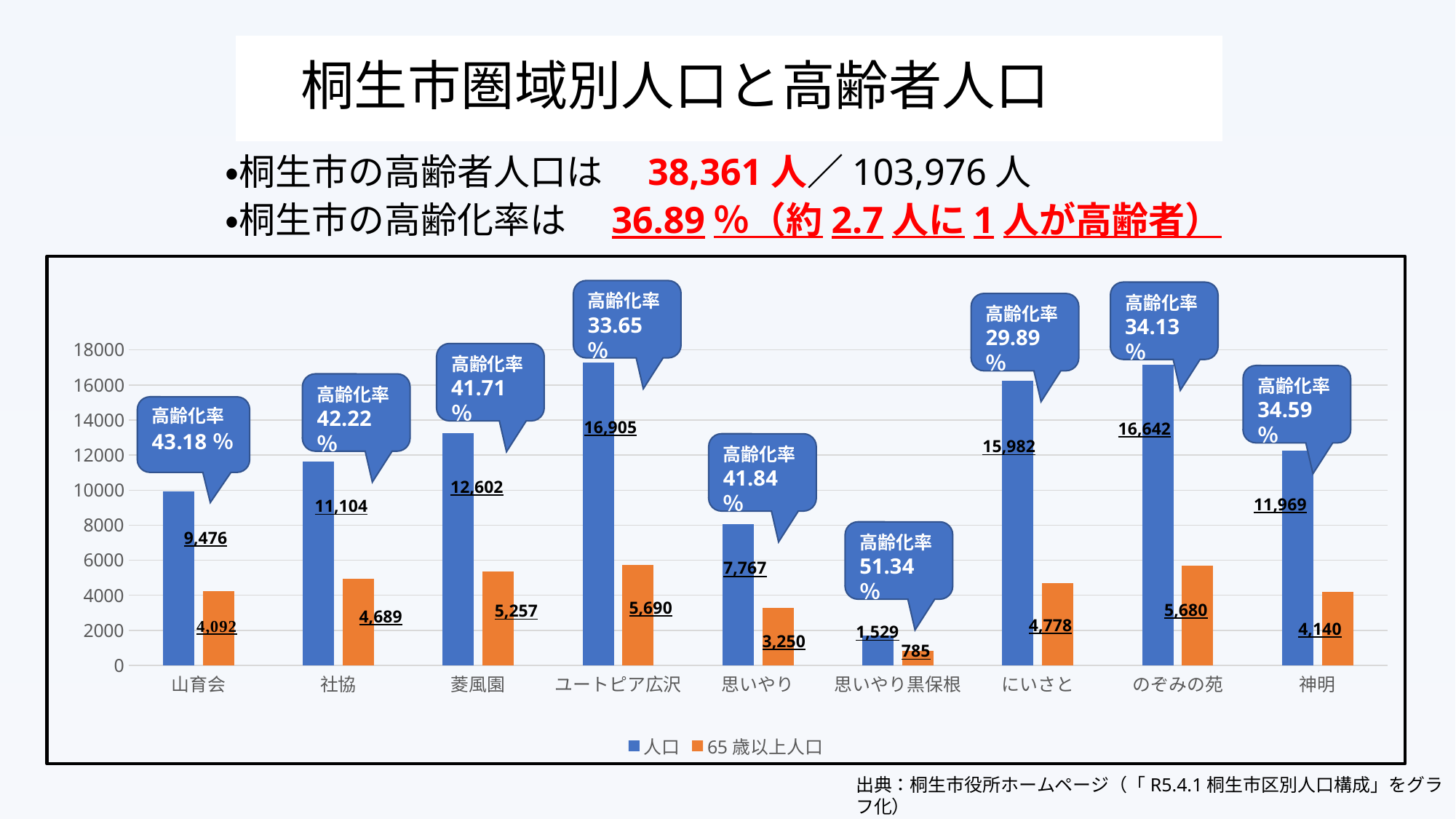
Which category has the lowest 人口 value? 思いやり黒保根 What is the 人口 value for ユートピア広沢? 16,905 What is the 65歳以上人口 value for 思いやり黒保根? 785 What 高齢化率 is shown in the callout for 思いやり黒保根? 51.34% How many categories are shown on the x axis of the chart? 9 Which has a larger 人口 value, にいさと or 神明? にいさと Which category has the highest 人口 value? ユートピア広沢 What is the difference between the 人口 values for 社協 and 山育会? 1,628 What is the difference between the 人口 and 65歳以上人口 values for ユートピア広沢? 11,215 How many series does the chart legend list? 2 What kind of chart is shown on the slide? Bar chart What is the 65歳以上人口 value for 社協? 4,689